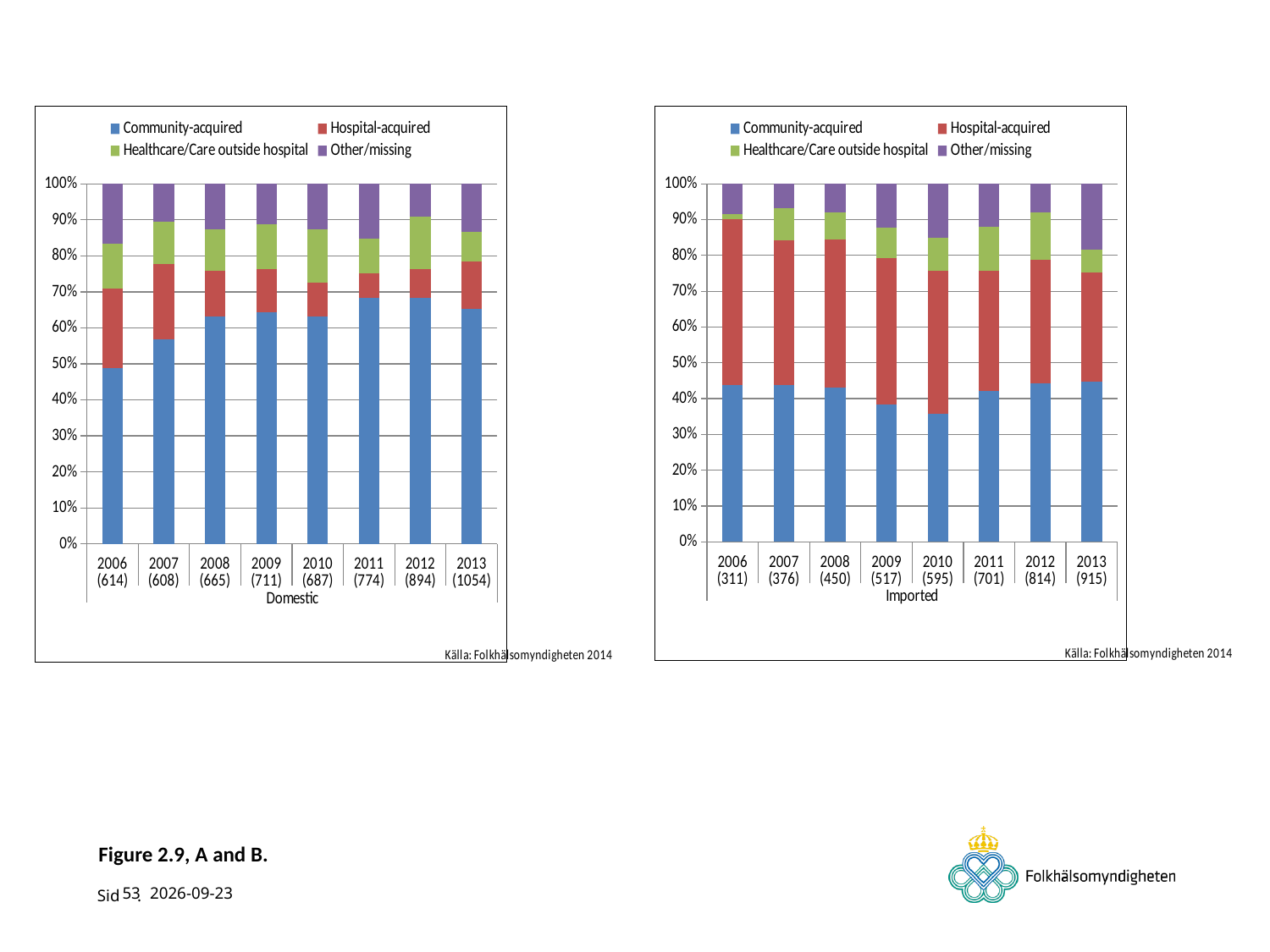
What kind of chart is the Domestic chart on the left? stacked bar chart How many series does the legend of the Imported chart list? 4 In the Imported chart, which year has the lowest Community-acquired share? 2010 In the Imported chart, what number is shown in parentheses under 2010? 595 In the Domestic chart, is the Community-acquired share for 2011 greater or less than 60%? greater How many year categories are shown on the x axis of the Domestic chart? 8 In the Imported chart, is the Community-acquired share for 2010 greater or less than 40%? less What colour represents Hospital-acquired in the legend of the Domestic chart? red In the Domestic chart, what number is shown in parentheses under 2013? 1054 In the Domestic chart, which year has the larger Community-acquired share, 2006 or 2013? 2013 In the Imported chart, which year has the larger Community-acquired share, 2010 or 2013? 2013 In the Domestic chart, which year has the lowest Community-acquired share? 2006